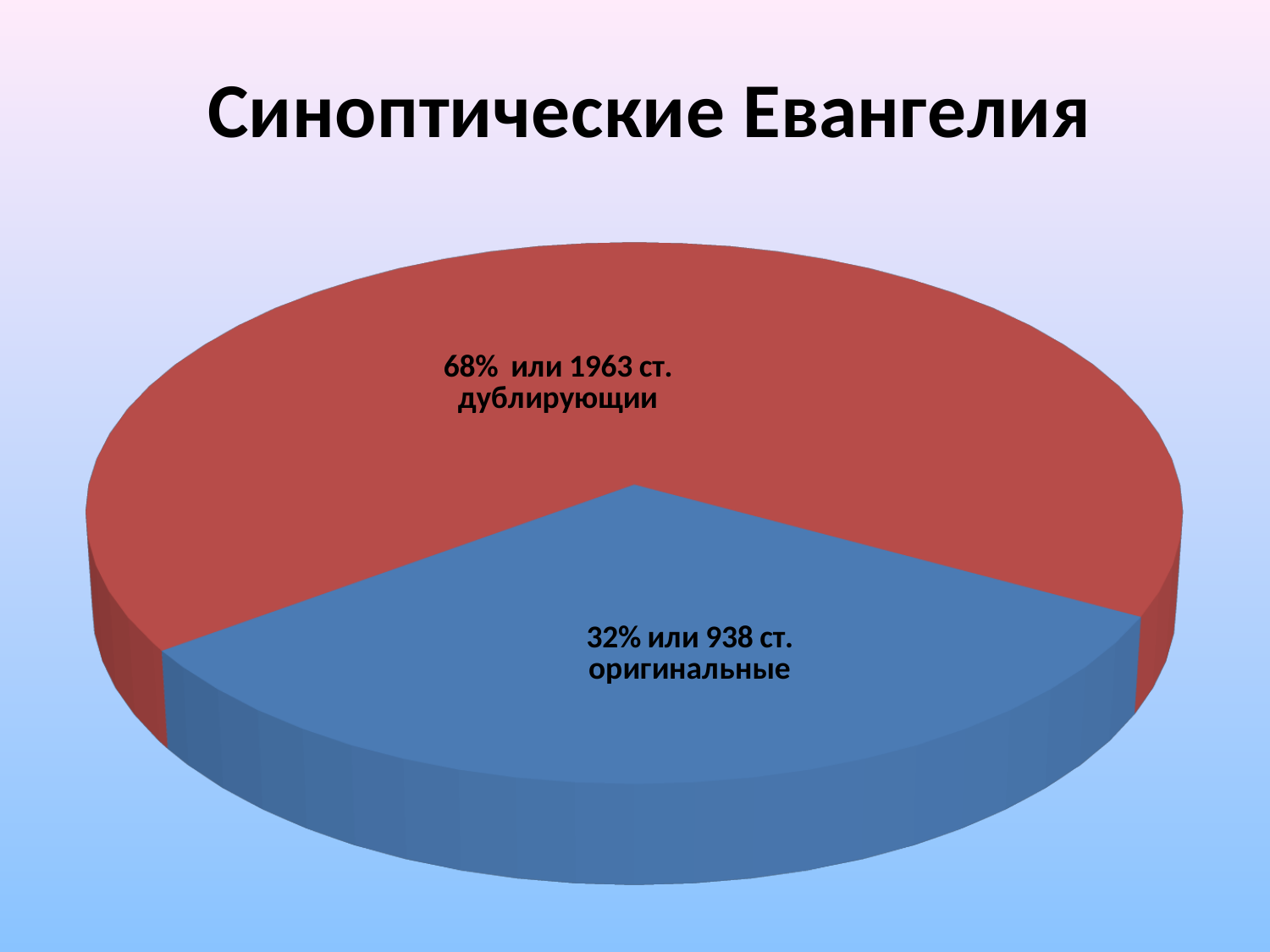
What percentage share does the 'дублирующии' slice have? 68% How many verses (ст.) are labelled as 'оригинальные'? 938 ст. Which is larger, the 'дублирующии' slice or the 'оригинальные' slice? дублирующии What is the title of the chart? Синоптические Евангелия What kind of chart is shown on the slide? pie chart Which slice is the smallest? оригинальные Which slice is the largest? дублирующии How many slices does the pie chart have? 2 What percentage share does the 'оригинальные' slice have? 32% What is the difference in verse count between 'дублирующии' and 'оригинальные'? 1025 ст. How many verses (ст.) are labelled as 'дублирующии'? 1963 ст. What colour is the 'оригинальные' slice? blue